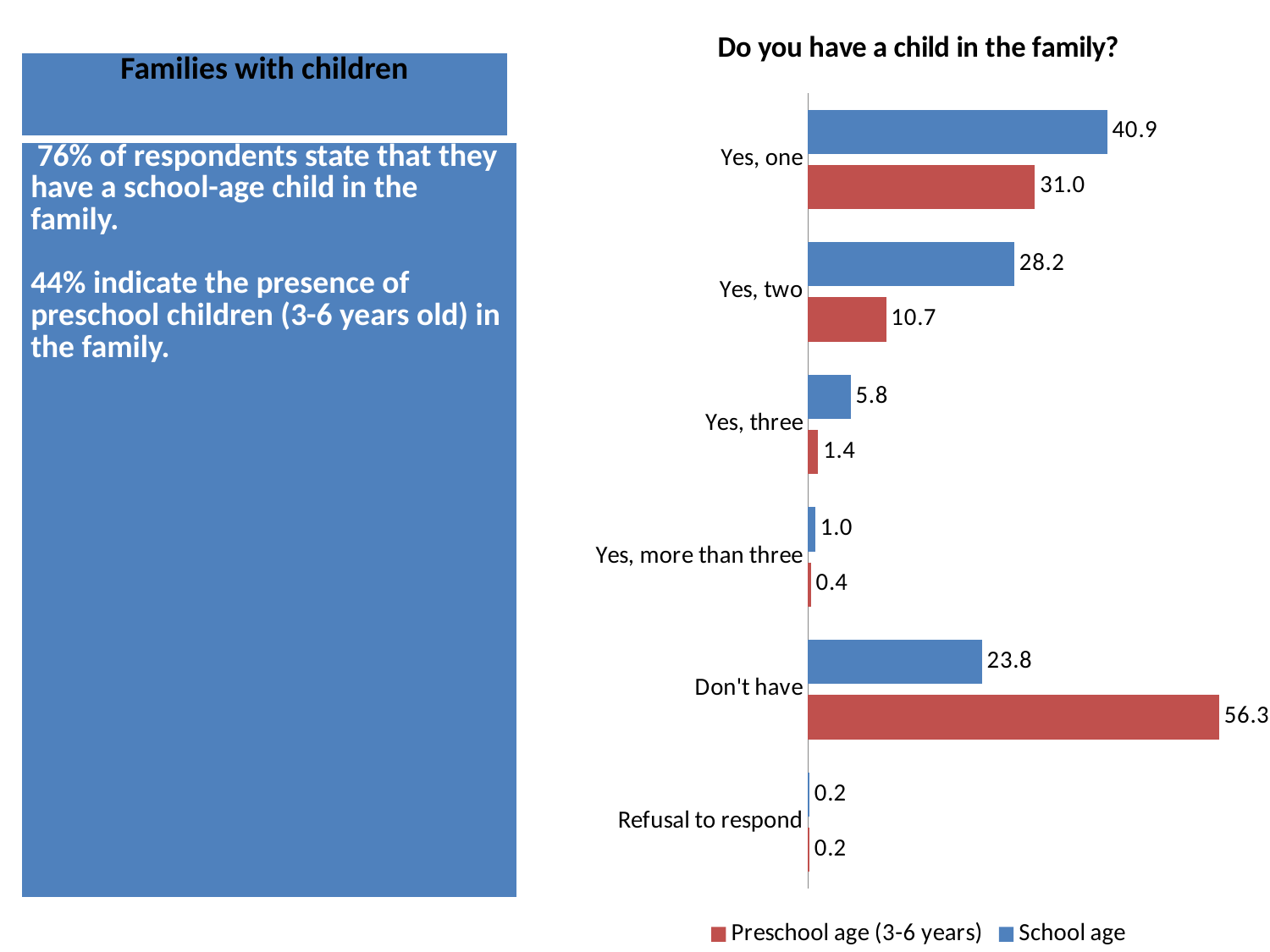
Which category has the highest Preschool age (3-6 years) value? Don't have How many categories are shown on the chart? 6 What is the title of the chart? Do you have a child in the family? Which category has the highest School age value? Yes, one What kind of chart is shown on the slide? Bar chart What is the School age value for "Yes, one"? 40.9 What is the Preschool age (3-6 years) value for "Don't have"? 56.3 For "Yes, three", which series has the larger value, School age or Preschool age (3-6 years)? School age What is the difference between the Preschool age (3-6 years) and School age values for "Don't have"? 32.5 What is the difference between the School age and Preschool age (3-6 years) values for "Yes, one"? 9.9 What is the Preschool age (3-6 years) value for "Yes, two"? 10.7 How many series does the legend list? 2